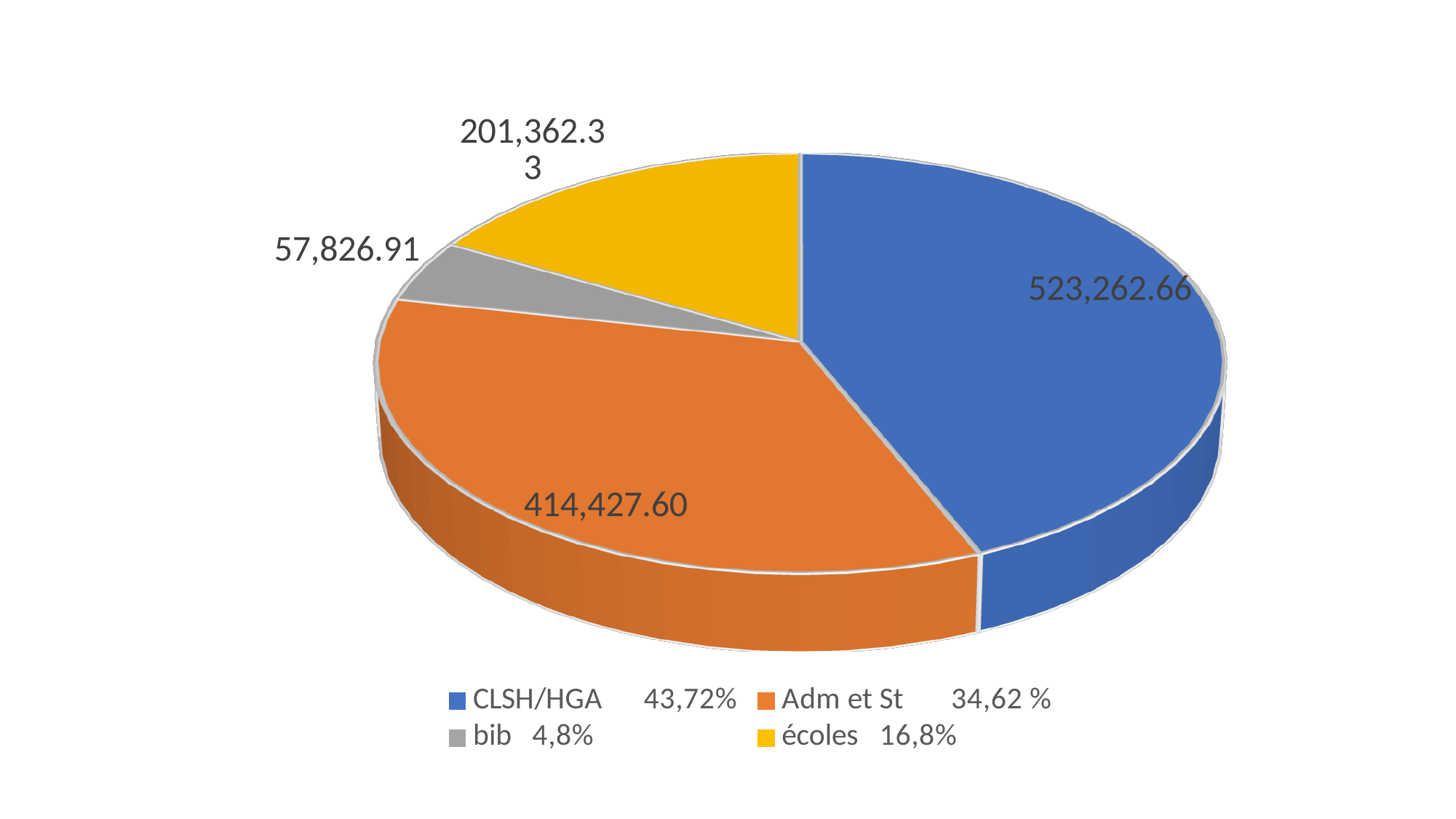
What is the value for Adm et St? 414,427.60 What is the value for écoles? 201,362.33 What is the difference between the values for CLSH/HGA and Adm et St? 108,835.06 Which category has the smallest slice? bib Which colour represents écoles in the pie chart? Yellow What is the value for CLSH/HGA? 523,262.66 How many slices does the pie chart have? 4 Which category has the largest slice? CLSH/HGA What is the value for bib? 57,826.91 Which is larger, the value for écoles or the value for bib? écoles What kind of chart is shown on the slide? Pie chart What share of the pie does Adm et St represent, according to the legend? 34,62 %